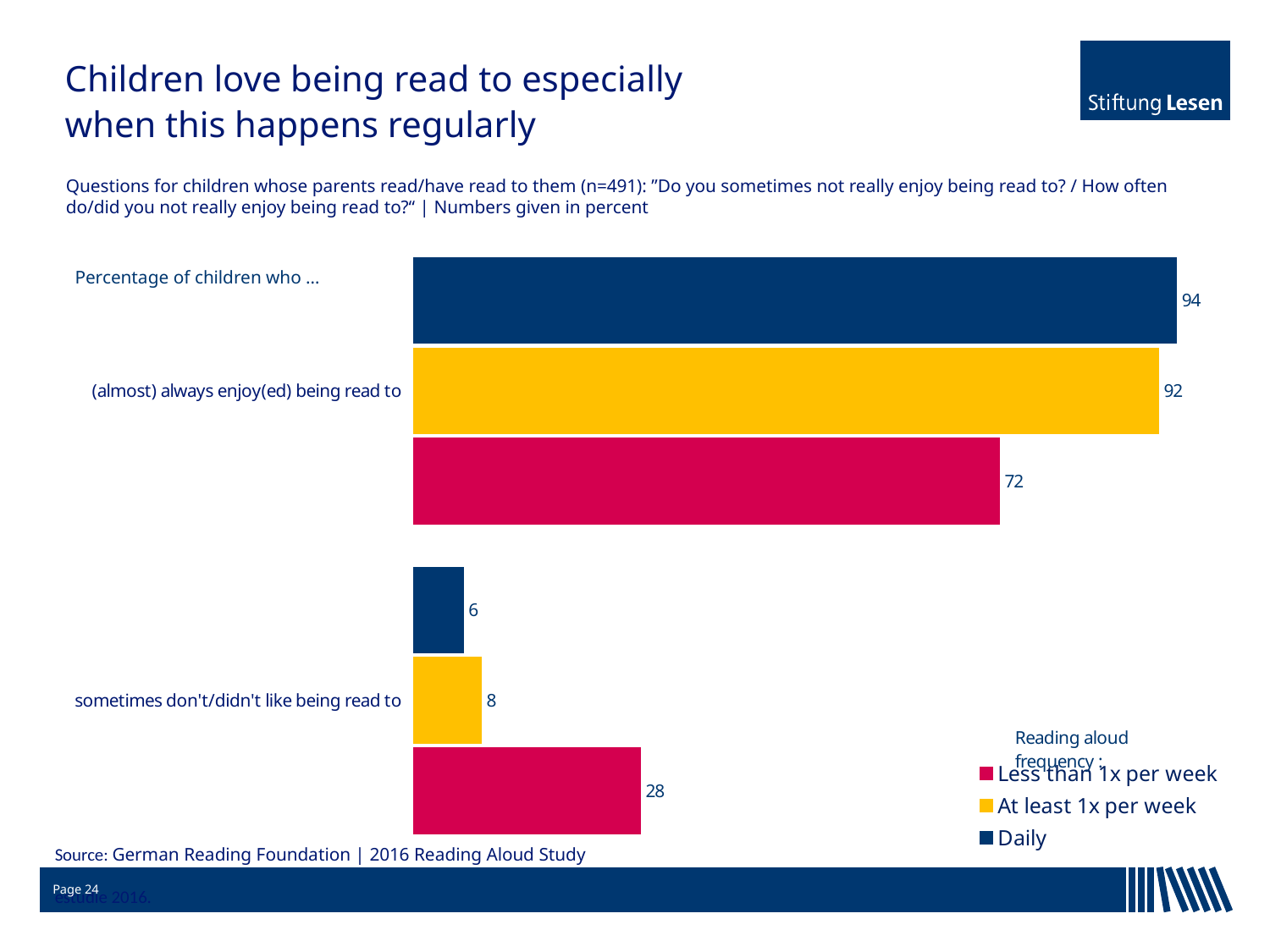
What kind of chart is shown on the slide? Bar chart What percentage of children who are read to less than 1x per week sometimes don't/didn't like being read to? 28 Which reading aloud frequency has the lowest value for 'sometimes don't/didn't like being read to'? Daily Which reading aloud frequency has the highest value for '(almost) always enjoy(ed) being read to'? Daily Which colour represents the 'At least 1x per week' series? Yellow What is the difference between the 'Less than 1x per week' and 'Daily' values for 'sometimes don't/didn't like being read to'? 22 How many series does the legend list? 3 For 'sometimes don't/didn't like being read to', which is larger: the value for 'At least 1x per week' or for 'Less than 1x per week'? Less than 1x per week What is the value for 'At least 1x per week' in the '(almost) always enjoy(ed) being read to' category? 92 What percentage of children who are read to daily (almost) always enjoy(ed) being read to? 94 What is the difference between the 'Daily' and 'Less than 1x per week' values for '(almost) always enjoy(ed) being read to'? 22 What is the value for 'Daily' in the 'sometimes don't/didn't like being read to' category? 6